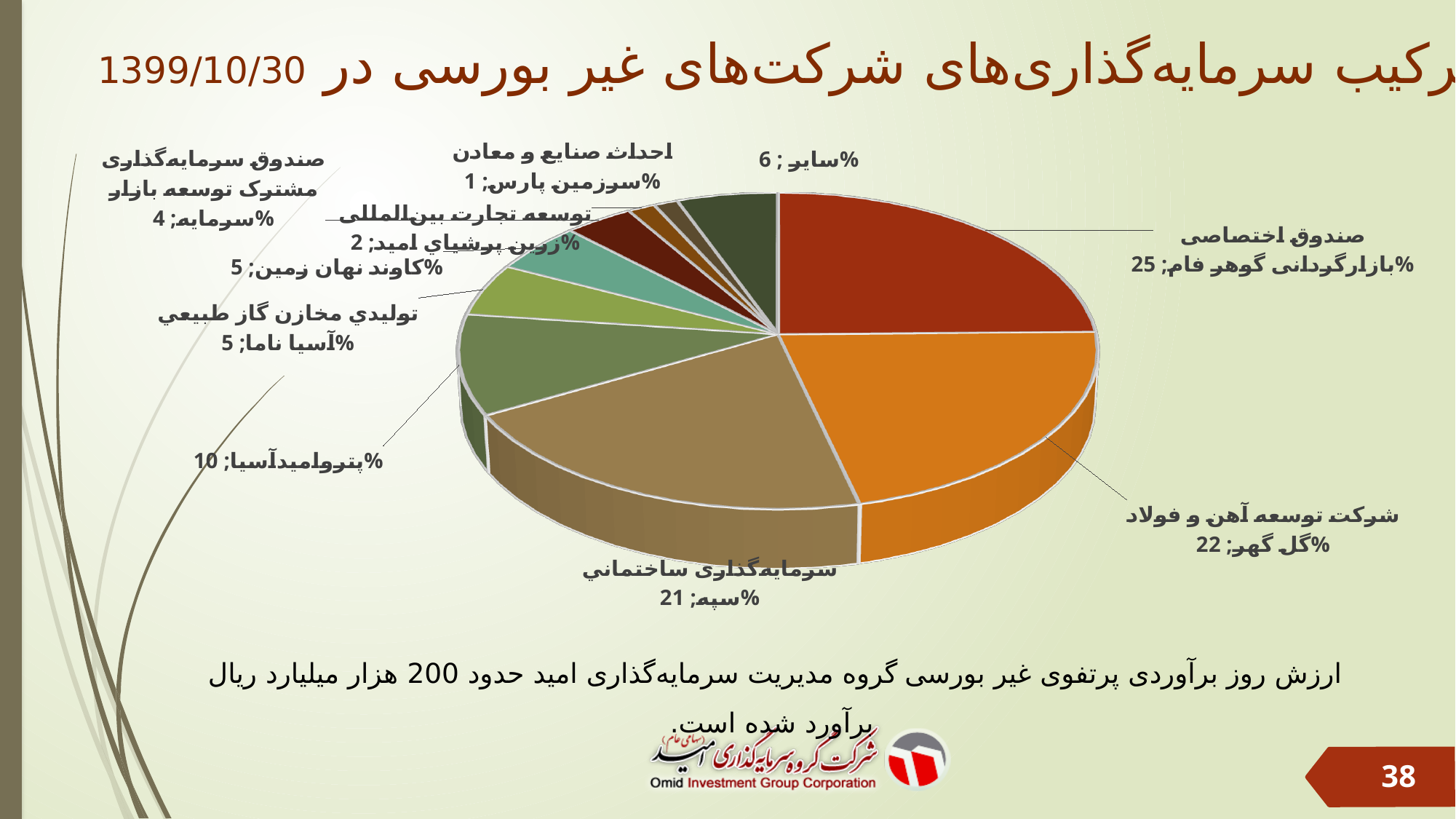
What is the value shown for سرمایه‌گذاری ساختمانی سپه? 21% What share of the pie does صندوق اختصاصی بازارگردانی گوهر فام hold? 25% Which slice has the largest share of the pie? صندوق اختصاصی بازارگردانی گوهر فام Which is larger, the share of پتروامیدآسیا or the share of سایر? پتروامیدآسیا What is the value shown for پتروامیدآسیا? 10% How many slices does the pie chart have? 10 What kind of chart is shown on the slide? pie chart What is the value shown for شرکت توسعه آهن و فولاد گل گهر? 22% What date is given in the slide title for this investment composition? 1399/10/30 What is the difference between the shares of صندوق اختصاصی بازارگردانی گوهر فام and شرکت توسعه آهن و فولاد گل گهر? 3% Which slice has the smallest share of the pie? احداث صنایع و معادن سرزمین پارس What is the value shown for the سایر (other) slice? 6%